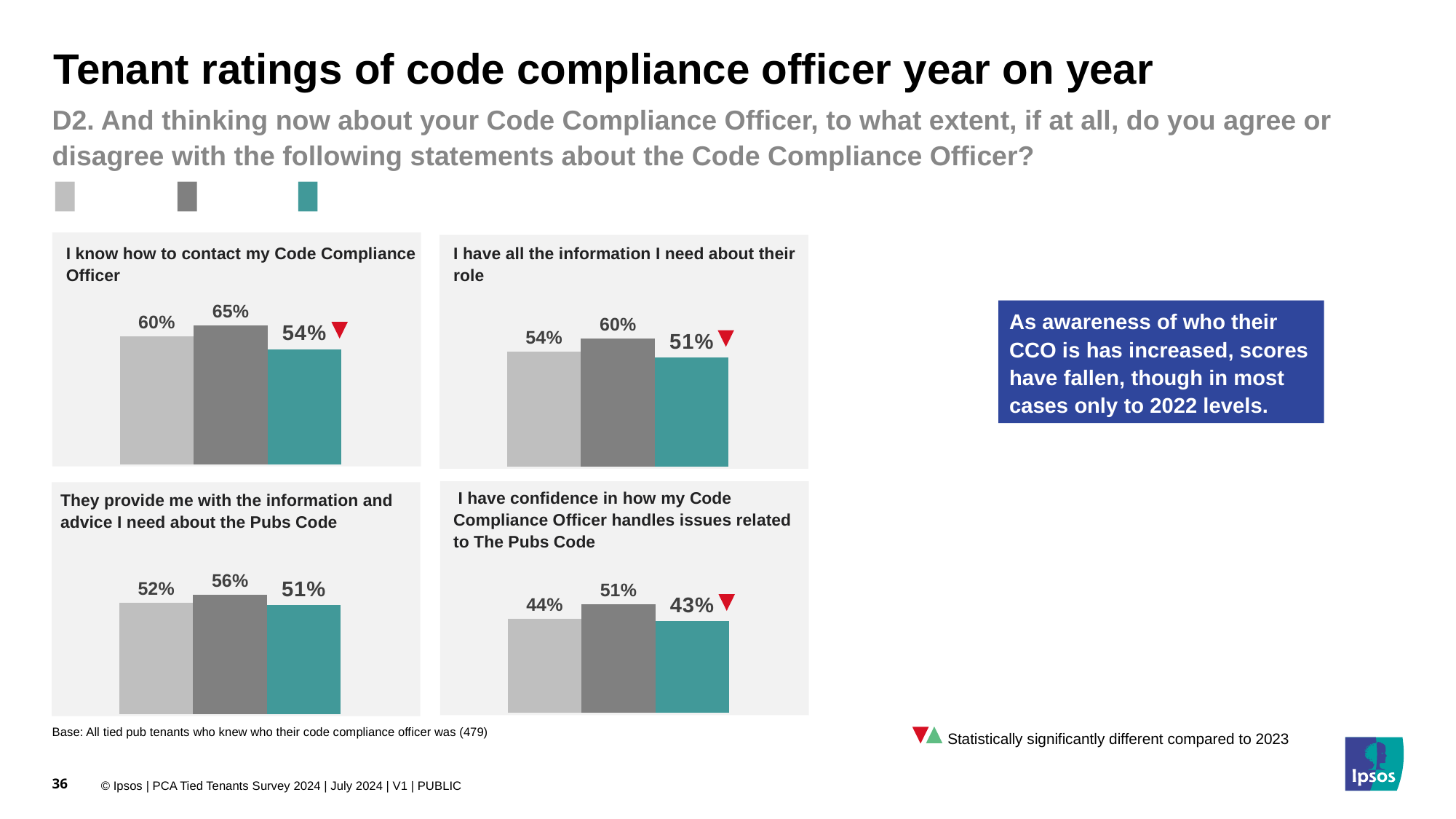
How many bars are shown in each of the four charts on the slide? 3 In the chart titled 'I have confidence in how my Code Compliance Officer handles issues related to The Pubs Code', which bar has the lowest value? The teal bar (43%) In the chart titled 'I have confidence in how my Code Compliance Officer handles issues related to The Pubs Code', what value is shown on the teal bar? 43% In the chart titled 'They provide me with the information and advice I need about the Pubs Code', which is larger: the light grey bar or the teal bar? The light grey bar (52%) In the chart titled 'They provide me with the information and advice I need about the Pubs Code', what value is shown on the dark grey bar? 56% In the chart titled 'I have all the information I need about their role', what is the difference between the dark grey bar and the light grey bar? 6 percentage points In the chart titled 'I know how to contact my Code Compliance Officer', which bar has the highest value? The dark grey bar (65%) In the chart titled 'I know how to contact my Code Compliance Officer', what value is shown on the teal bar? 54% In the chart titled 'I know how to contact my Code Compliance Officer', what is the difference between the dark grey bar and the teal bar? 11 percentage points How many of the four charts show a red downward triangle next to the teal bar? 3 In the chart titled 'I have all the information I need about their role', what value is shown on the light grey bar? 54% What type of chart is used for each of the four statements on the slide? Bar chart